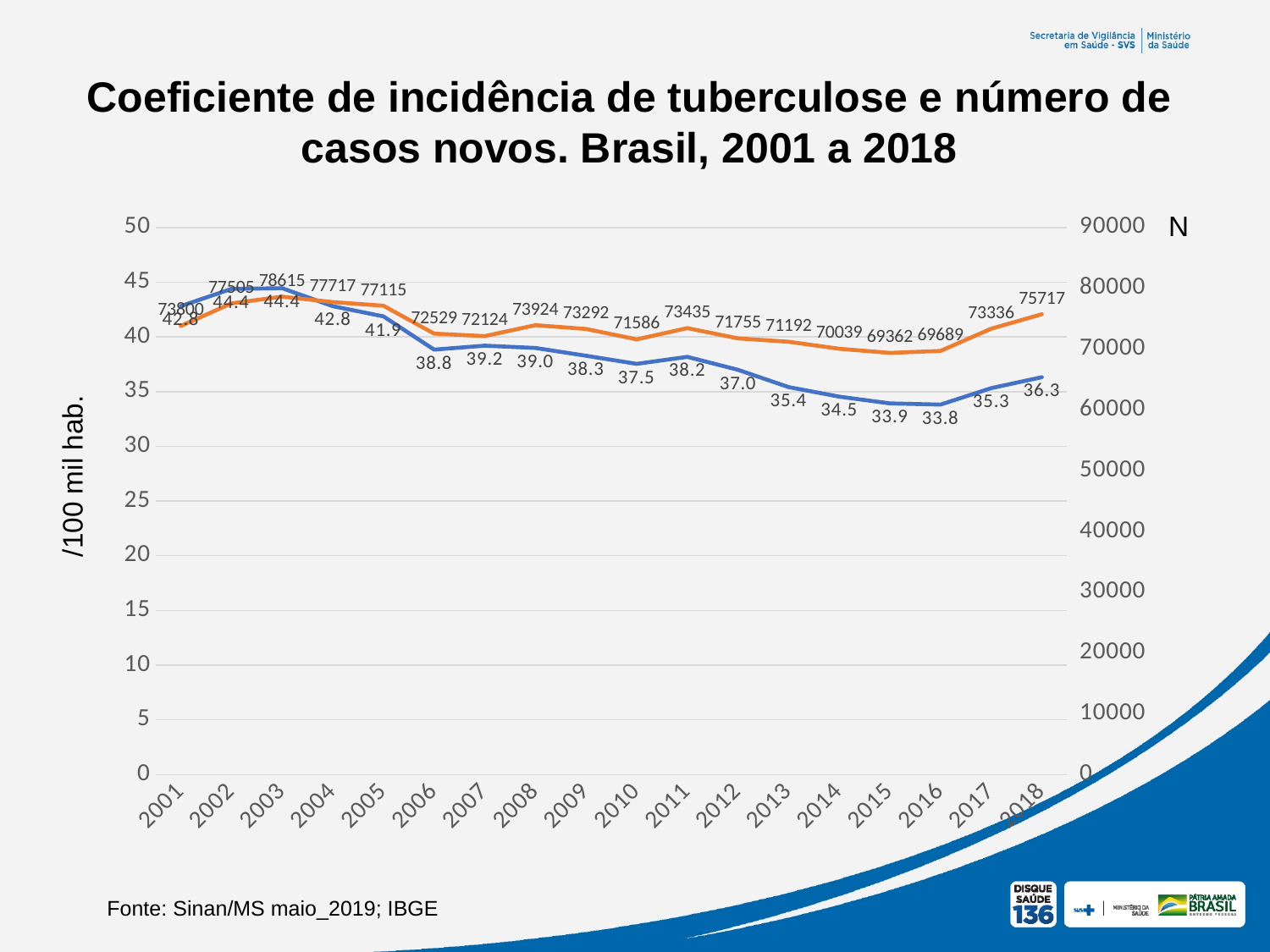
What is the difference between the incidence coefficient in 2001 and in 2018? 6.5 What is the tuberculosis incidence coefficient (per 100 mil hab.) for 2018? 36.3 How many new tuberculosis cases are shown for 2003? 78615 Which year has more new cases, 2015 or 2018? 2018 What kind of chart is shown on the slide? Line chart Does the incidence coefficient rise or fall from 2003 to 2016? Fall Is the number of new cases in 2014 greater or less than 60000? greater In which year is the number of new cases highest? 2003 How many years are plotted on the x axis? 18 In which year is the incidence coefficient lowest? 2016 What is the incidence coefficient shown for 2010? 37.5 By how many cases did the number of new cases increase from 2017 to 2018? 2381